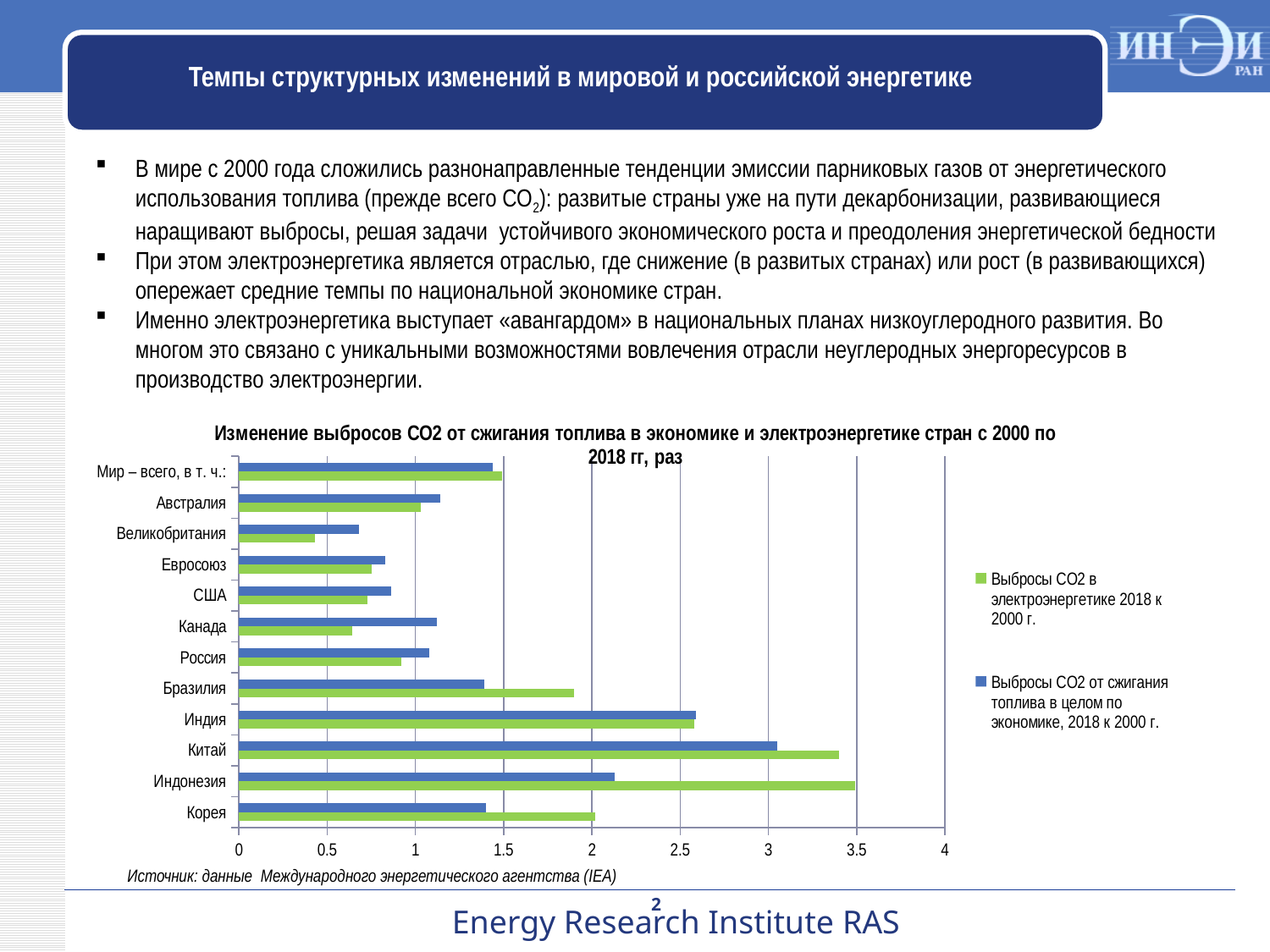
Which country has the lowest value for the series 'Выбросы CO2 в электроэнергетике 2018 к 2000 г.'? Великобритания Is the value for Великобритания in the series 'Выбросы CO2 в электроэнергетике 2018 к 2000 г.' greater or less than 0.5? less Which is larger for Бразилия: the value for 'Выбросы CO2 в электроэнергетике 2018 к 2000 г.' or the value for 'Выбросы CO2 от сжигания топлива в целом по экономике, 2018 к 2000 г.'? Выбросы CO2 в электроэнергетике 2018 к 2000 г. How many series does the chart legend list? 2 What kind of chart is shown on the slide? Bar chart Which is larger for Канада: the value for 'Выбросы CO2 в электроэнергетике 2018 к 2000 г.' or the value for 'Выбросы CO2 от сжигания топлива в целом по экономике, 2018 к 2000 г.'? Выбросы CO2 от сжигания топлива в целом по экономике, 2018 к 2000 г. Is the value for Китай in the series 'Выбросы CO2 в электроэнергетике 2018 к 2000 г.' greater or less than 3? greater Which country has the lowest value for the series 'Выбросы CO2 от сжигания топлива в целом по экономике, 2018 к 2000 г.'? Великобритания How many countries/regions are listed on the vertical axis of the chart? 12 What is the title of the chart? Изменение выбросов CO2 от сжигания топлива в экономике и электроэнергетике стран с 2000 по 2018 гг, раз Is the value for Бразилия in the series 'Выбросы CO2 в электроэнергетике 2018 к 2000 г.' greater or less than 1.5? greater Which country has the highest value for the series 'Выбросы CO2 от сжигания топлива в целом по экономике, 2018 к 2000 г.'? Китай